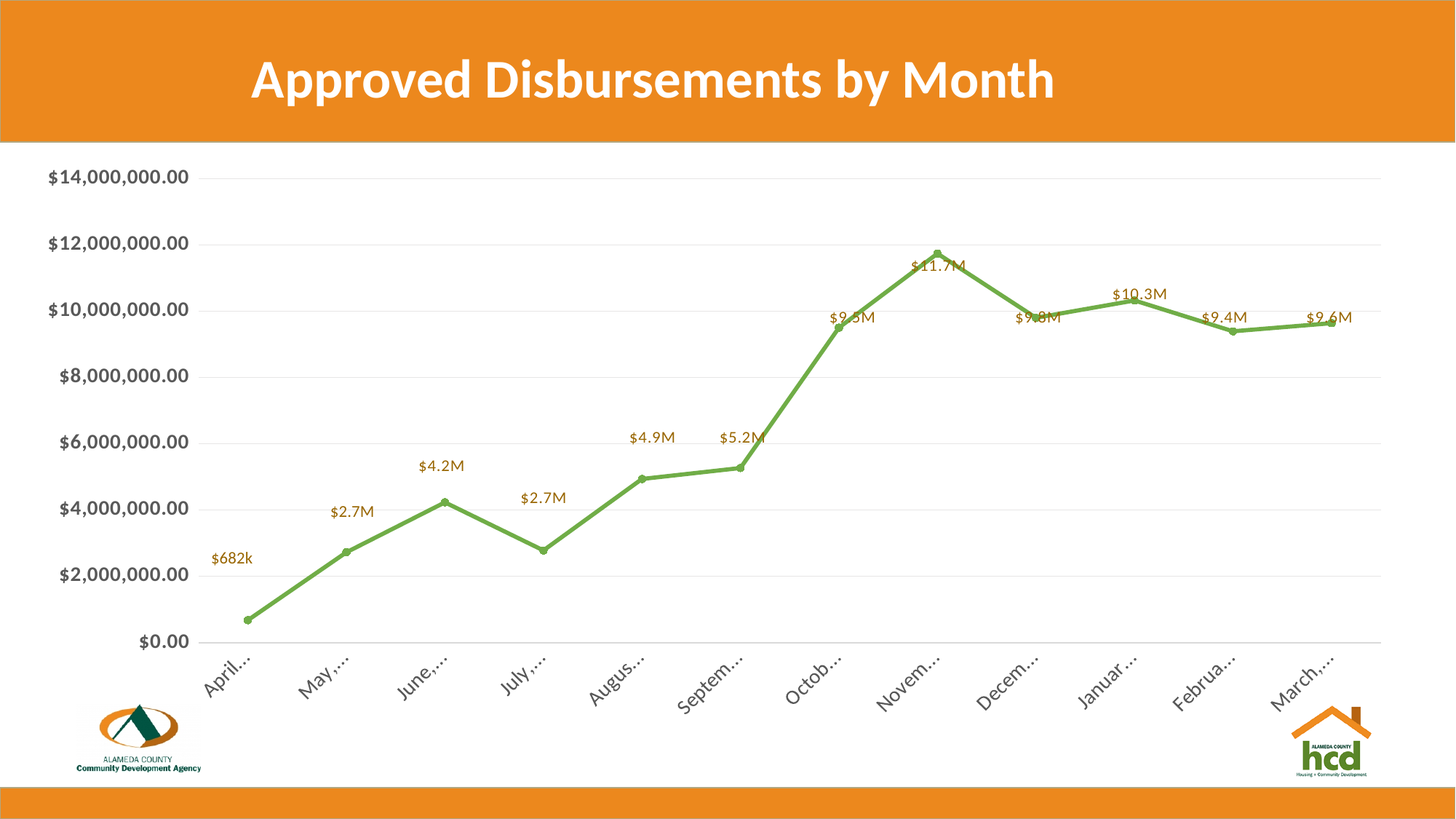
Do the values generally rise or fall from April to November? Rise What type of chart is shown on the slide? Line chart Is the value for February greater or less than $10,000,000.00? less What is the difference between the labelled values for November and October? $2.2M How many months are plotted on the chart? 12 Which is larger, the value for October or the value for September? October Which month has the lowest approved disbursement? April Which month has the highest approved disbursement? November What is the title of the chart? Approved Disbursements by Month What is the approved disbursement value labelled for November? $11.7M What is the approved disbursement value labelled for April? $682k What is the approved disbursement value labelled for January? $10.3M